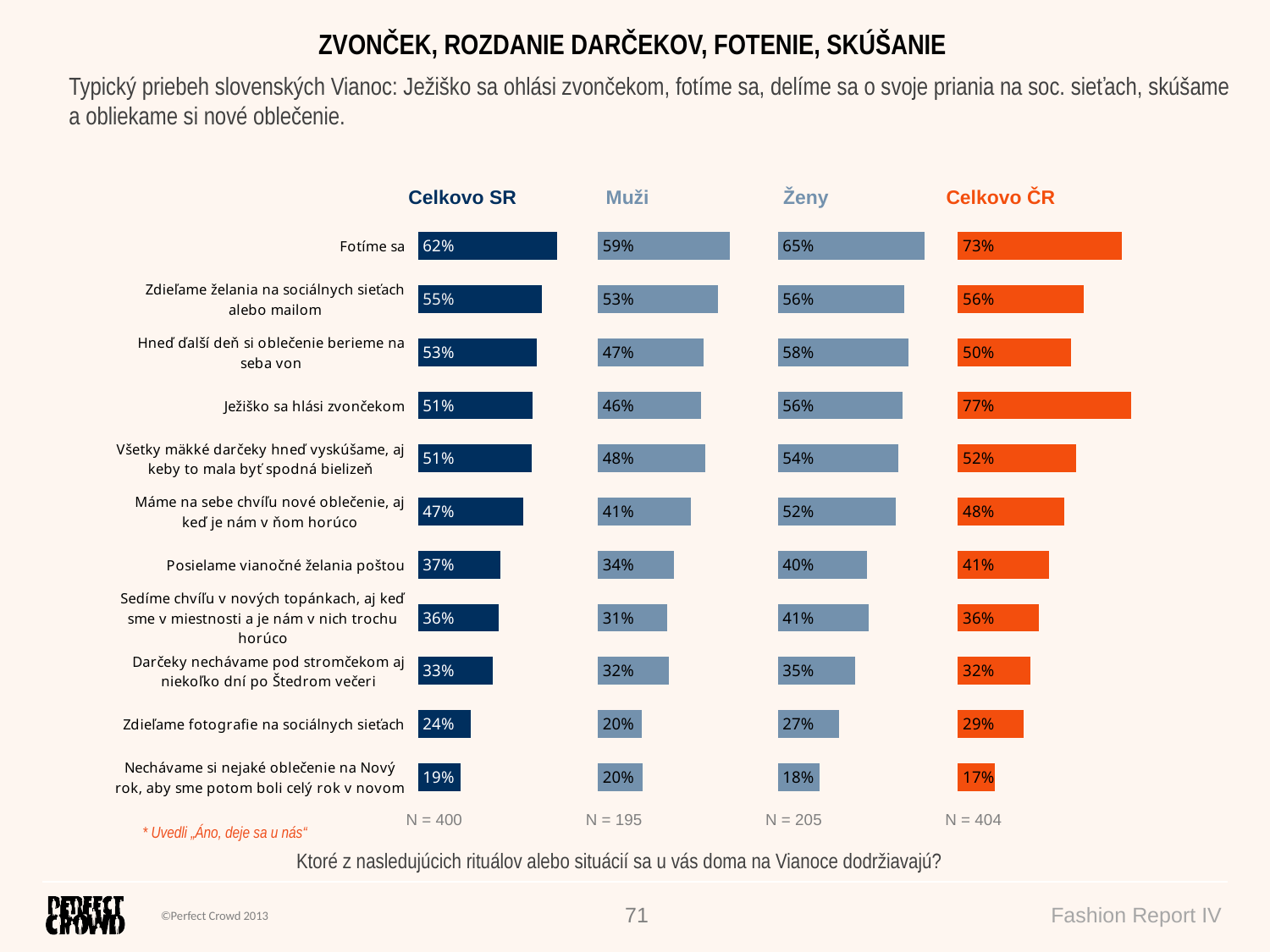
How many categories are shown in the Celkovo SR chart? 11 In the Muži chart, what is the value for "Posielame vianočné želania poštou"? 34% In the Celkovo SR chart, what is the value for "Fotíme sa"? 62% For "Ježiško sa hlási zvončekom", which is larger: the Muži value or the Ženy value? Ženy In the Celkovo ČR chart, which category has the lowest value? Nechávame si nejaké oblečenie na Nový rok, aby sme potom boli celý rok v novom In the Celkovo SR chart, what is the difference between "Fotíme sa" and "Zdieľame fotografie na sociálnych sieťach"? 38% In the Celkovo ČR chart, what is the value for "Ježiško sa hlási zvončekom"? 77% What kind of chart is used for the Celkovo ČR data? bar chart In the Ženy chart, what is the value for "Hneď ďalší deň si oblečenie berieme na seba von"? 58% What colour are the bars in the Celkovo ČR chart? orange What is the sample size (N) shown under the Muži chart? N = 195 In the Ženy chart, which category has the highest value? Fotíme sa